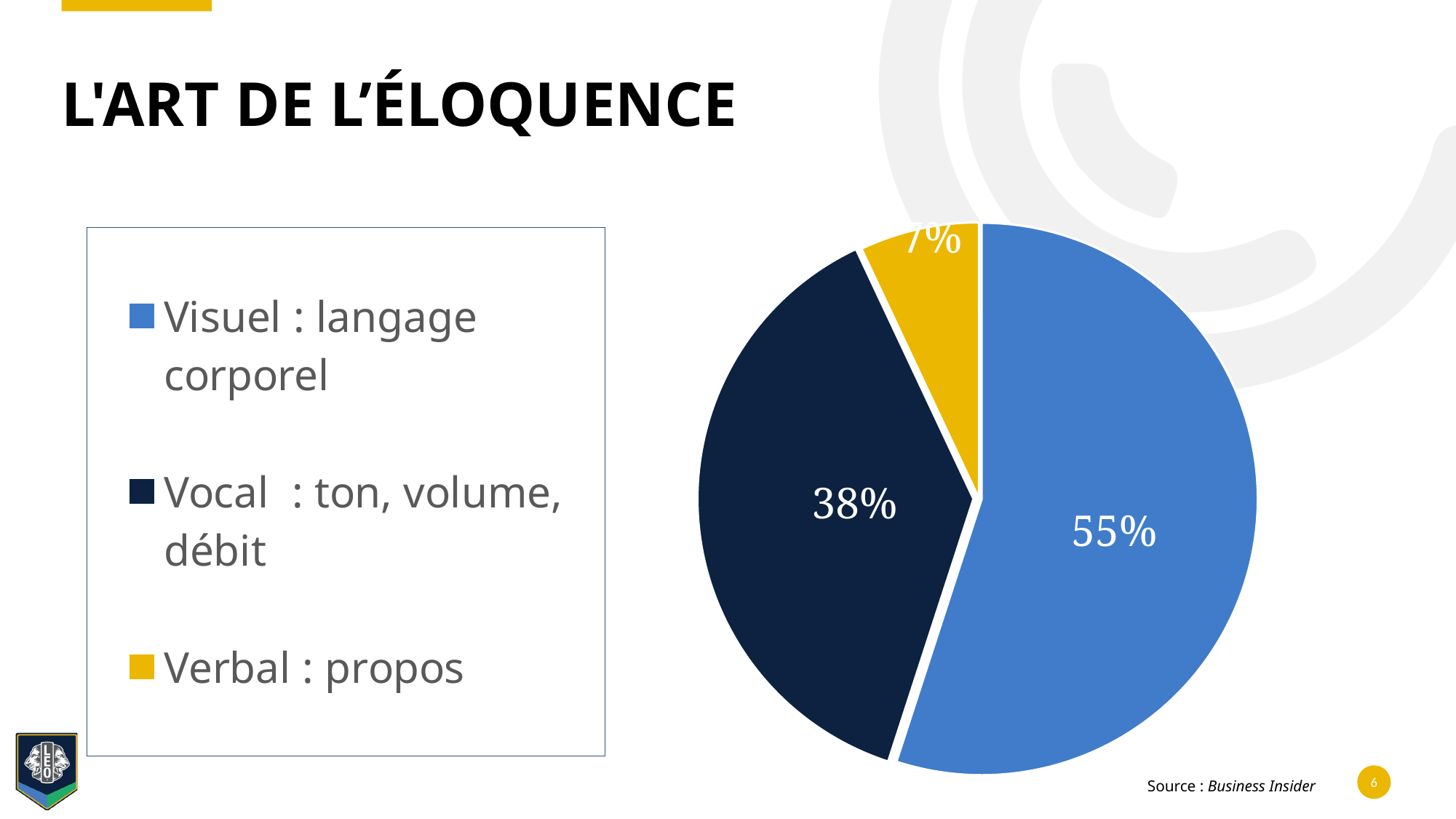
Which is larger, the 'Vocal' slice or the 'Verbal' slice? Vocal What colour is the 'Verbal : propos' slice? yellow What share of the pie does the 'Verbal : propos' slice represent? 7% Which category has the smallest slice of the pie? Verbal : propos What share of the pie does the 'Vocal : ton, volume, débit' slice represent? 38% How many slices does the pie chart have? 3 What is the difference in percentage points between the 'Vocal' slice and the 'Verbal' slice? 31 What is the difference in percentage points between the 'Visuel' slice and the 'Vocal' slice? 17 What share of the pie does the 'Visuel : langage corporel' slice represent? 55% What kind of chart is shown on the slide? pie chart Which category has the largest slice of the pie? Visuel : langage corporel How many entries does the legend list? 3